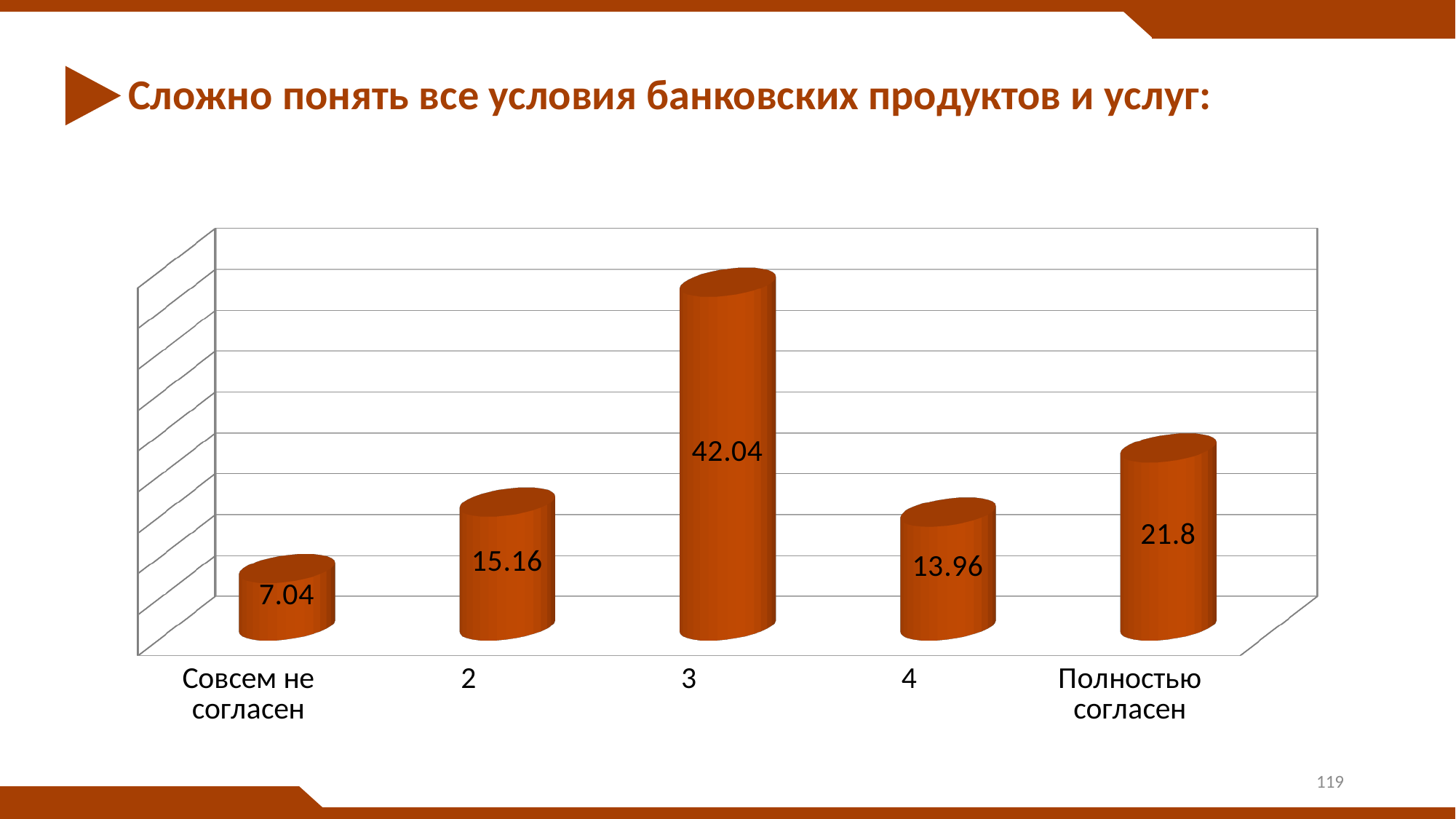
Which category has the highest value? 3 Which category has the lowest value? Совсем не согласен What is the difference between the values for "2" and "Совсем не согласен"? 8.12 What kind of chart is shown on the slide? bar chart What is the difference between the values for "3" and "Полностью согласен"? 20.24 How many categories are shown on the x axis? 5 What is the title of the slide above the chart? Сложно понять все условия банковских продуктов и услуг: What is the value for "Совсем не согласен"? 7.04 What is the value for the category "3"? 42.04 What is the value for "Полностью согласен"? 21.8 What is the value for the category "4"? 13.96 Which is larger, the value for "2" or the value for "4"? 2